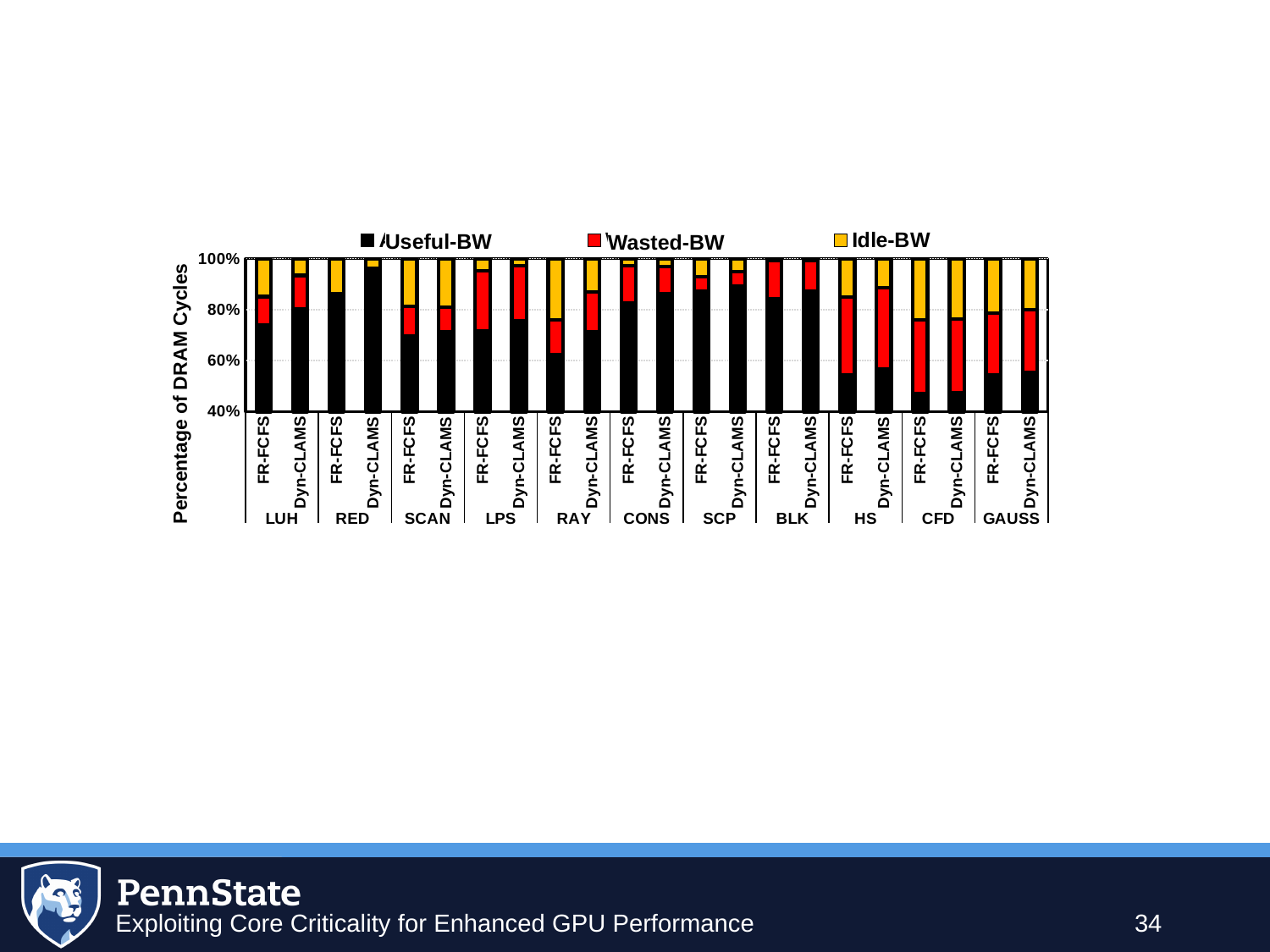
What kind of chart is shown on the slide? Stacked bar chart How many series does the legend list? 3 Which benchmark has the highest Useful-BW under Dyn-CLAMS? RED How many benchmark groups are shown along the x axis? 11 How many stacked bars are plotted in total? 22 Is the Useful-BW value for RED under Dyn-CLAMS greater or less than 80%? greater Is the Useful-BW value for CFD under FR-FCFS greater or less than 60%? less Is the Useful-BW value for BLK under FR-FCFS greater or less than 80%? greater Which benchmark has the lowest Useful-BW under FR-FCFS? CFD For LUH, which scheduler has the larger Useful-BW, FR-FCFS or Dyn-CLAMS? Dyn-CLAMS Which series is drawn in black? Useful-BW What is the label of the y axis? Percentage of DRAM Cycles